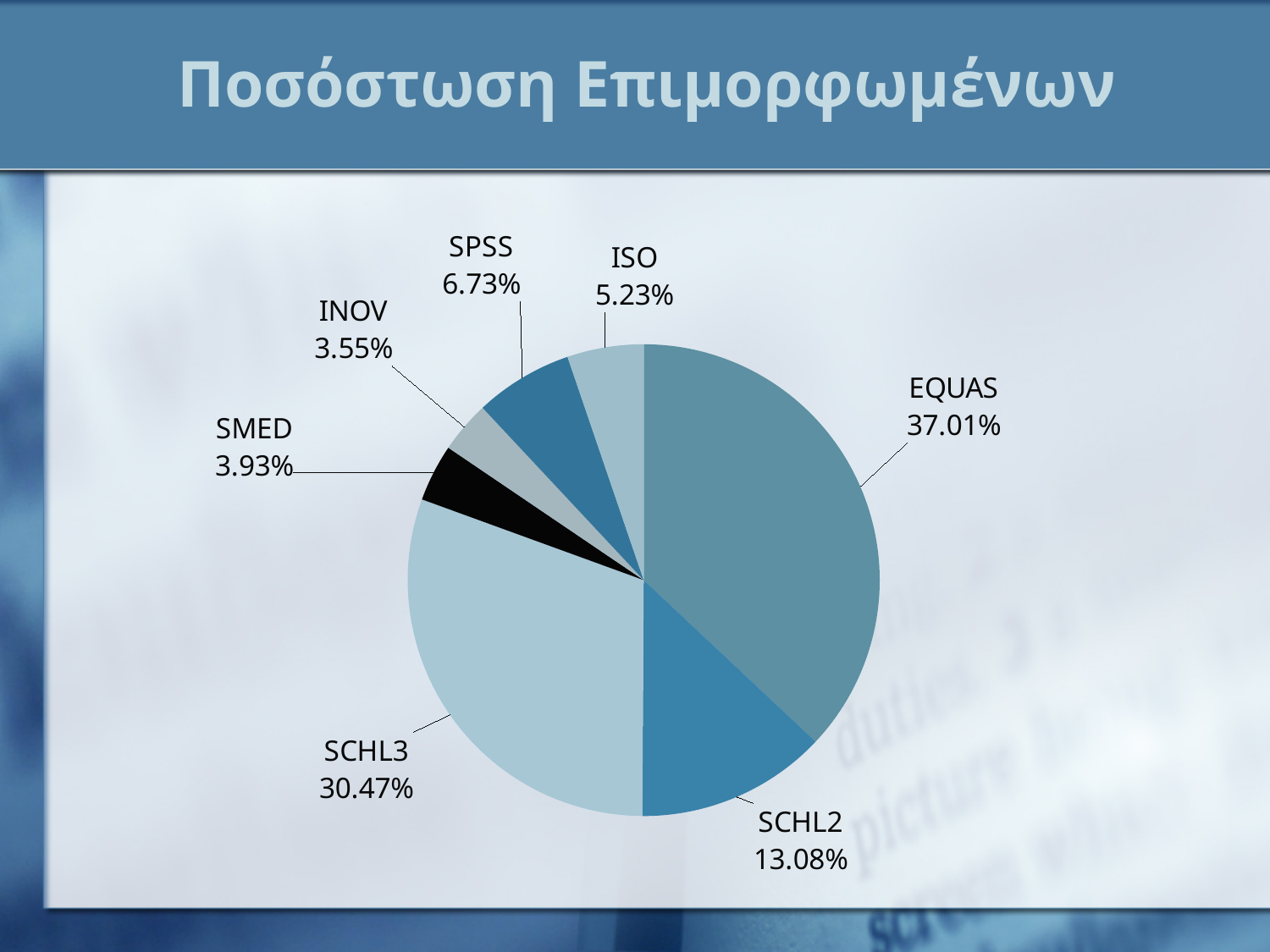
What is the share for SPSS? 6.73% Which category has the smallest slice of the pie? INOV What is the title of the chart on the slide? Ποσόστωση Επιμορφωμένων What is the share for ISO? 5.23% Which is larger, the share for SMED or the share for INOV? SMED Which category has the largest slice of the pie? EQUAS What type of chart is shown on the slide? pie chart What is the share for SCHL3? 30.47% What is the share for SCHL2? 13.08% What is the share for EQUAS? 37.01% What is the difference in percentage points between EQUAS and SCHL3? 6.54 How many slices does the pie chart have? 7